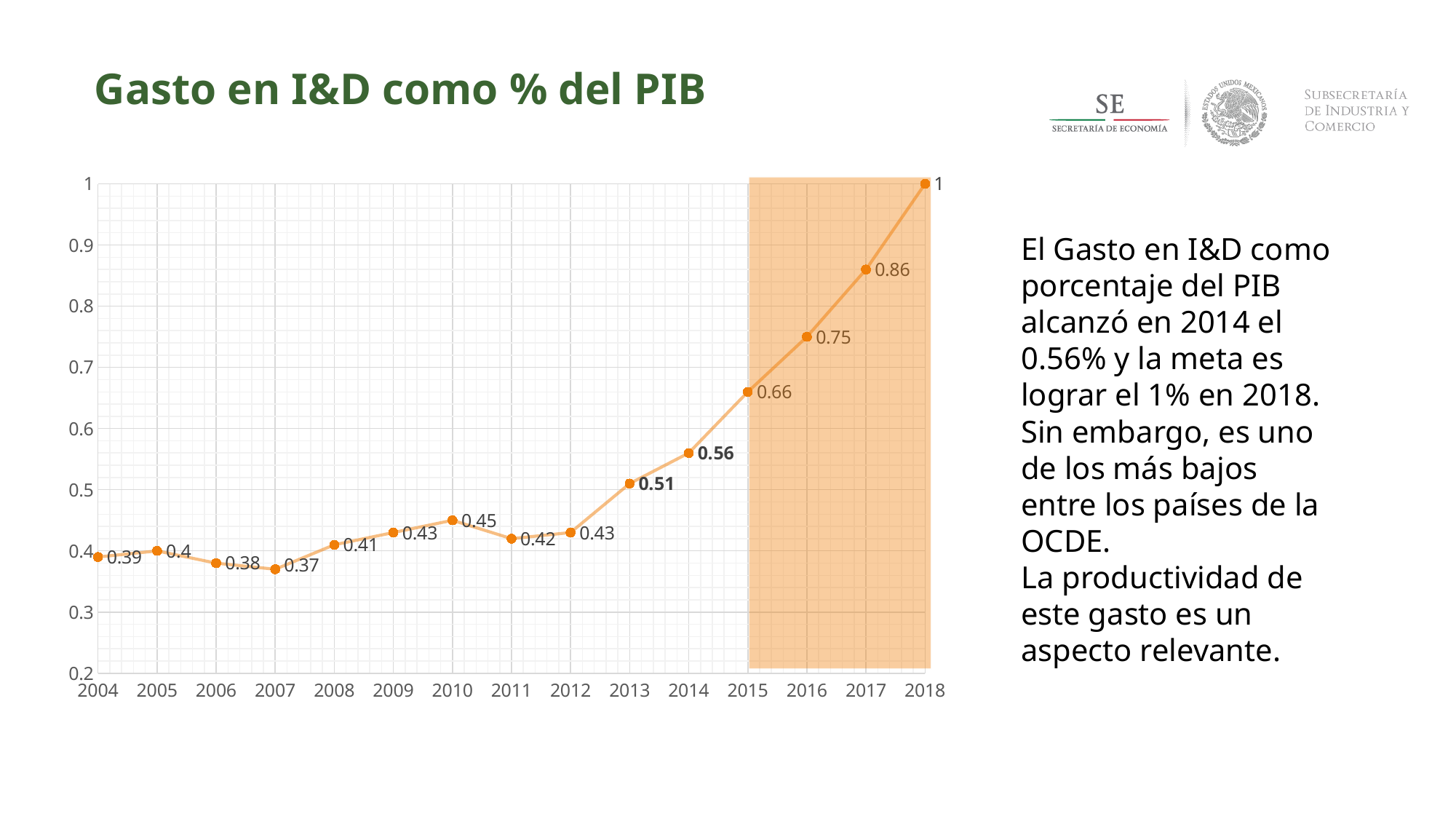
What is the title of the chart? Gasto en I&D como % del PIB Which year has the highest value? 2018 Is the value for 2017 greater or less than 0.8? greater What is the value for 2016? 0.75 Which is larger, the value for 2010 or the value for 2011? 2010 Which year has the lowest value? 2007 What is the value for 2007? 0.37 How many years are plotted on the x axis? 15 Do the values rise or fall from 2012 to 2018? Rise What is the value for 2014? 0.56 What kind of chart is shown? Line chart What is the difference between the values for 2018 and 2014? 0.44